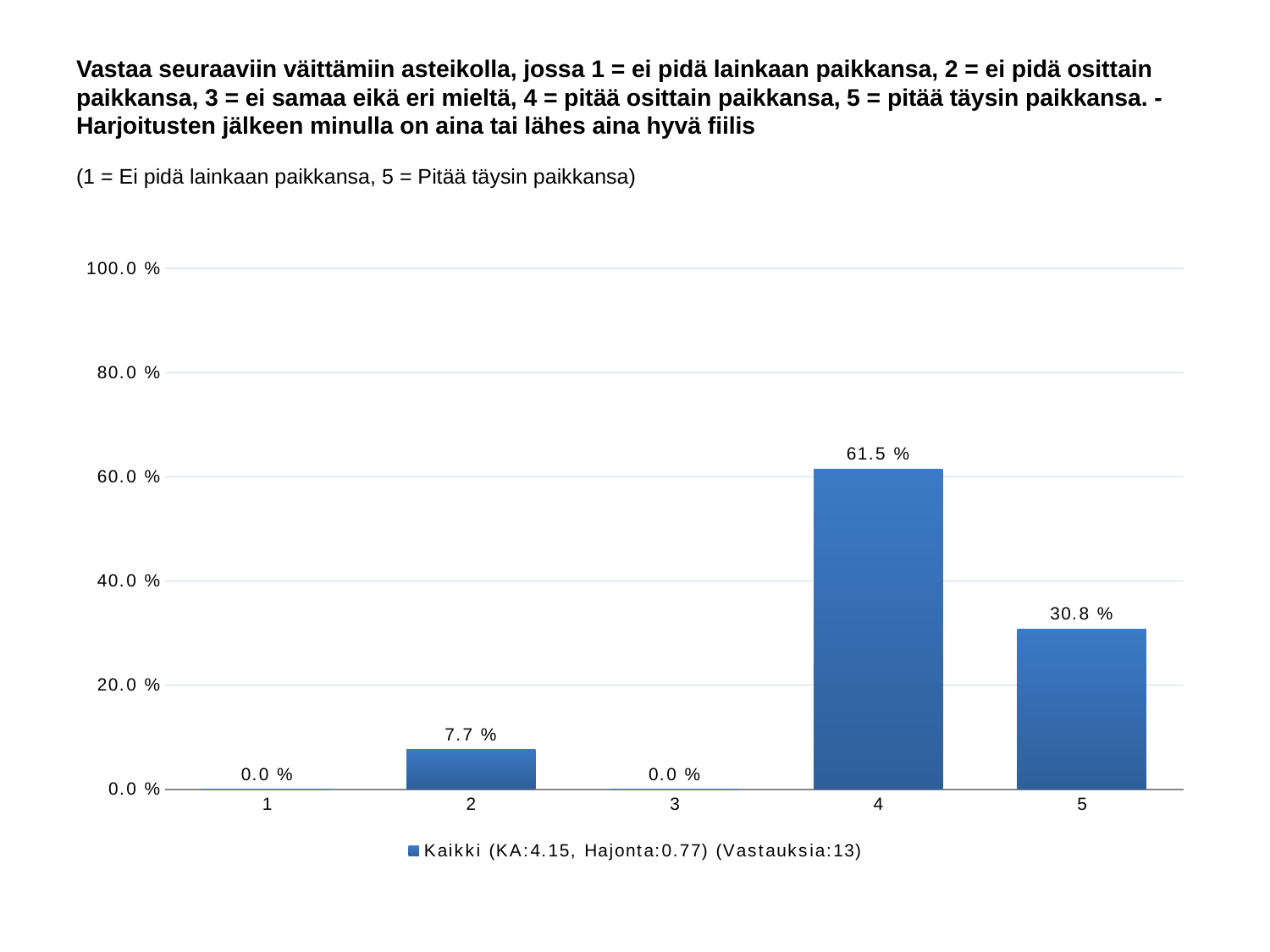
How many categories are shown on the x axis? 5 Which is larger, the value for category 2 or the value for category 5? 5 What is the difference between the values for categories 4 and 5? 30.7 % What is the number of responses (Vastauksia) given in the legend? 13 What is the value for category 5? 30.8 % What kind of chart is shown on the slide? bar chart How many series does the legend list? 1 What is the value for category 4? 61.5 % What is the value for category 1? 0.0 % Which category has the highest value? 4 Is the value for category 4 greater or less than 60.0 %? greater What is the value for category 2? 7.7 %